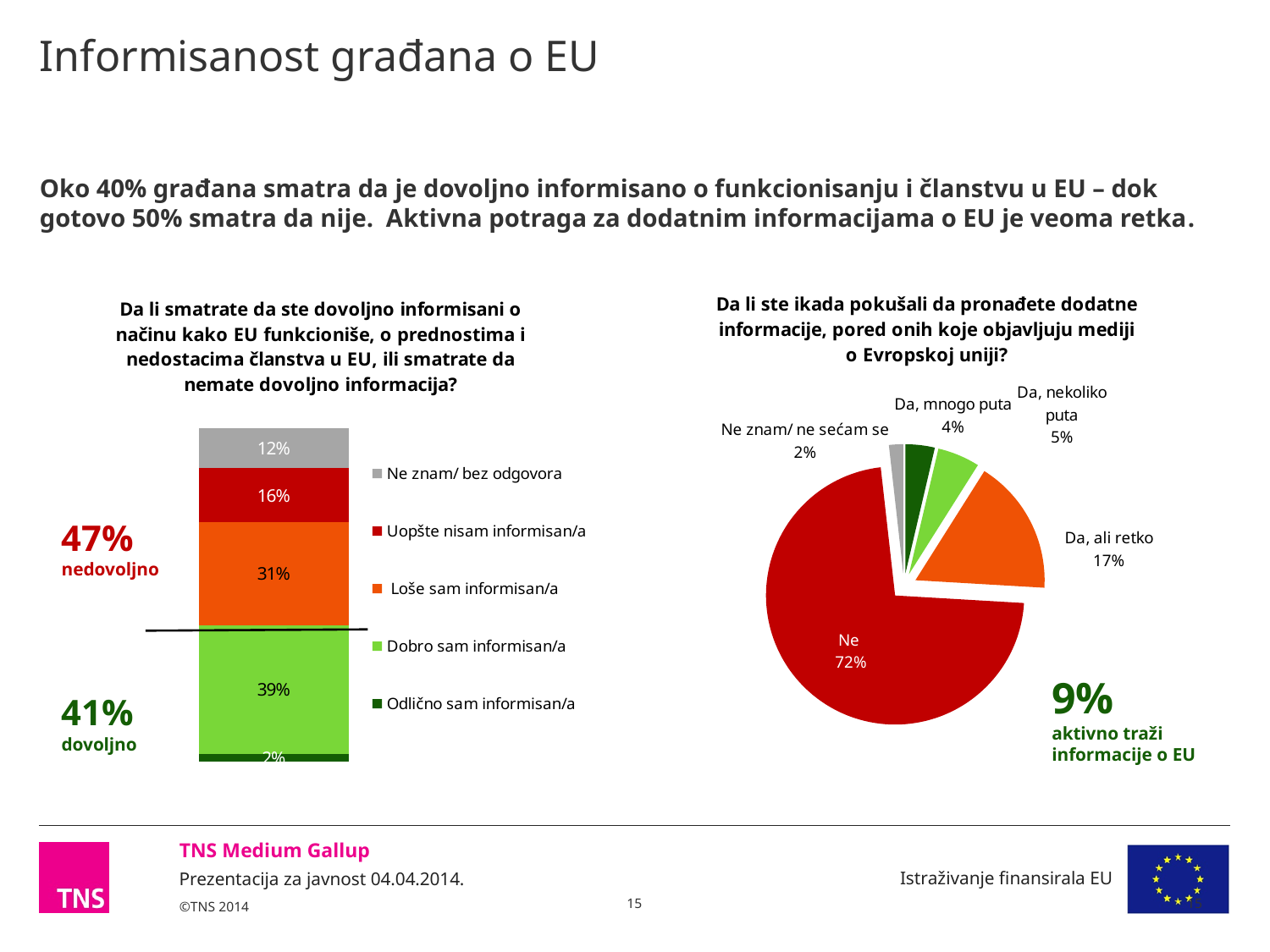
In the pie chart on the right, which answer has the smallest slice? Ne znam/ ne sećam se In the pie chart on the right, what share of respondents answered "Ne"? 72% In the stacked bar chart on the left, how many entries does the legend list? 5 In the stacked bar chart on the left, which is larger: "Uopšte nisam informisan/a" or "Ne znam/ bez odgovora"? Uopšte nisam informisan/a In the pie chart on the right, what is the difference in percentage points between "Da, nekoliko puta" and "Da, mnogo puta"? 1 percentage point In the stacked bar chart on the left, which category has the largest segment? Dobro sam informisan/a In the stacked bar chart on the left, what percentage of respondents said "Dobro sam informisan/a"? 39% What type of chart is shown on the right side of the slide? Pie chart In the pie chart on the right, which answer has the largest slice? Ne In the pie chart on the right, how many slices are there? 5 In the pie chart on the right, what percentage answered "Da, ali retko"? 17% In the stacked bar chart on the left, what percentage of respondents said "Loše sam informisan/a"? 31%